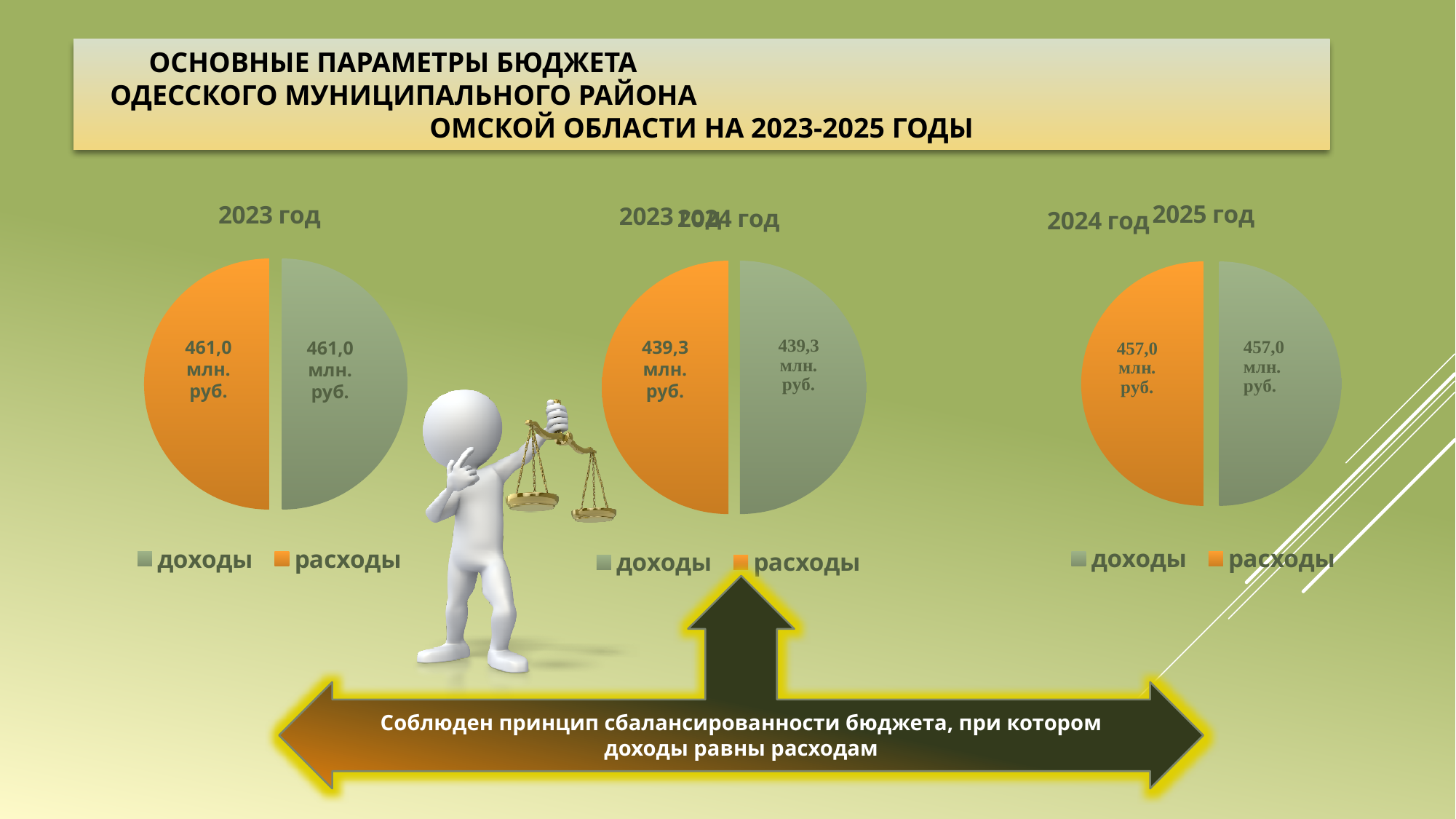
On the left pie chart (2023 год), what is the difference between доходы and расходы? 0,0 млн. руб. How many entries does the legend of the middle pie chart list? 2 On the right pie chart, what share of the pie does the расходы slice represent? 50% On the right pie chart, what is the value for расходы? 457,0 млн. руб. What kind of chart is used for each of the three charts on the slide? Pie chart On the middle pie chart, what is the value for доходы? 439,3 млн. руб. How many slices does the left pie chart (2023 год) have? 2 On the right pie chart, what is the value for доходы? 457,0 млн. руб. On the middle pie chart, which colour represents расходы? Orange On the left pie chart (2023 год), what is the value for доходы? 461,0 млн. руб. On the middle pie chart, what is the value for расходы? 439,3 млн. руб. On the left pie chart (2023 год), what is the value for расходы? 461,0 млн. руб.